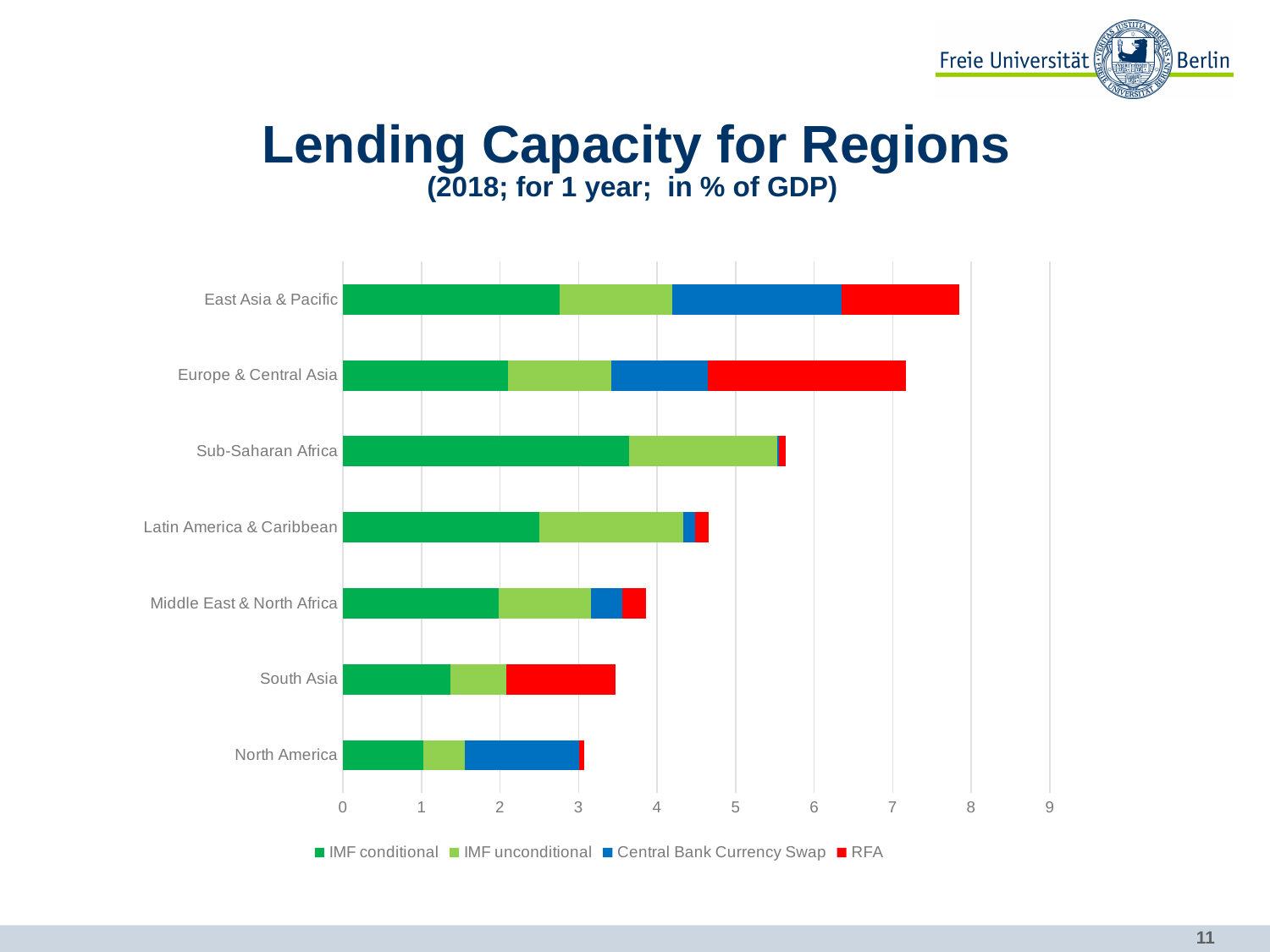
Which region has the shortest total bar? North America Is the total bar for South Asia greater or less than 4? less What kind of chart is shown on the slide? Stacked bar chart Which total bar is longer, Sub-Saharan Africa or Latin America & Caribbean? Sub-Saharan Africa How many series does the legend list? 4 Which region has the longest total bar? East Asia & Pacific Is the total bar for East Asia & Pacific greater or less than 7? greater Which region has the largest RFA segment? Europe & Central Asia Is the total bar for Sub-Saharan Africa greater or less than 5? greater What is the title of the chart? Lending Capacity for Regions How many regions are plotted in the chart? 7 Which region has the largest IMF conditional segment? Sub-Saharan Africa